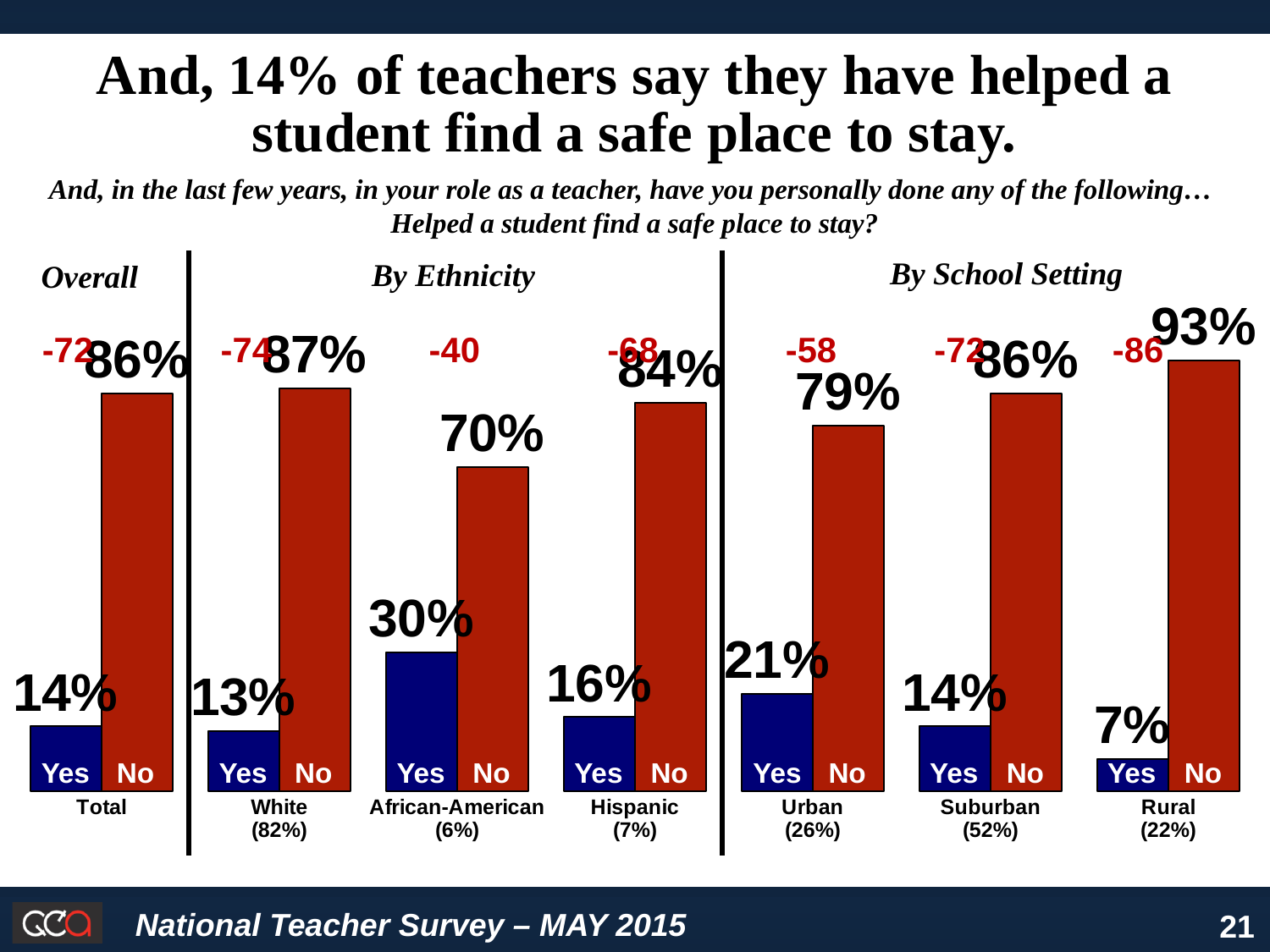
What is the Yes value for Rural teachers? 7% What kind of chart is shown on the slide? Bar chart What is the No value for African-American teachers? 70% Which is larger, the Yes value for Urban teachers or the Yes value for Suburban teachers? Urban Which group has the highest Yes percentage? African-American How many groups (categories) are shown along the x axis? 7 What red net figure is shown above the Rural bars? -86 What percentage of teachers overall (Total) say Yes, they have helped a student find a safe place to stay? 14% What is the No value for Urban teachers? 79% Which group has the highest No percentage? Rural What is the difference between the No and Yes values for Hispanic teachers? 68% Which group has the lowest Yes percentage? Rural